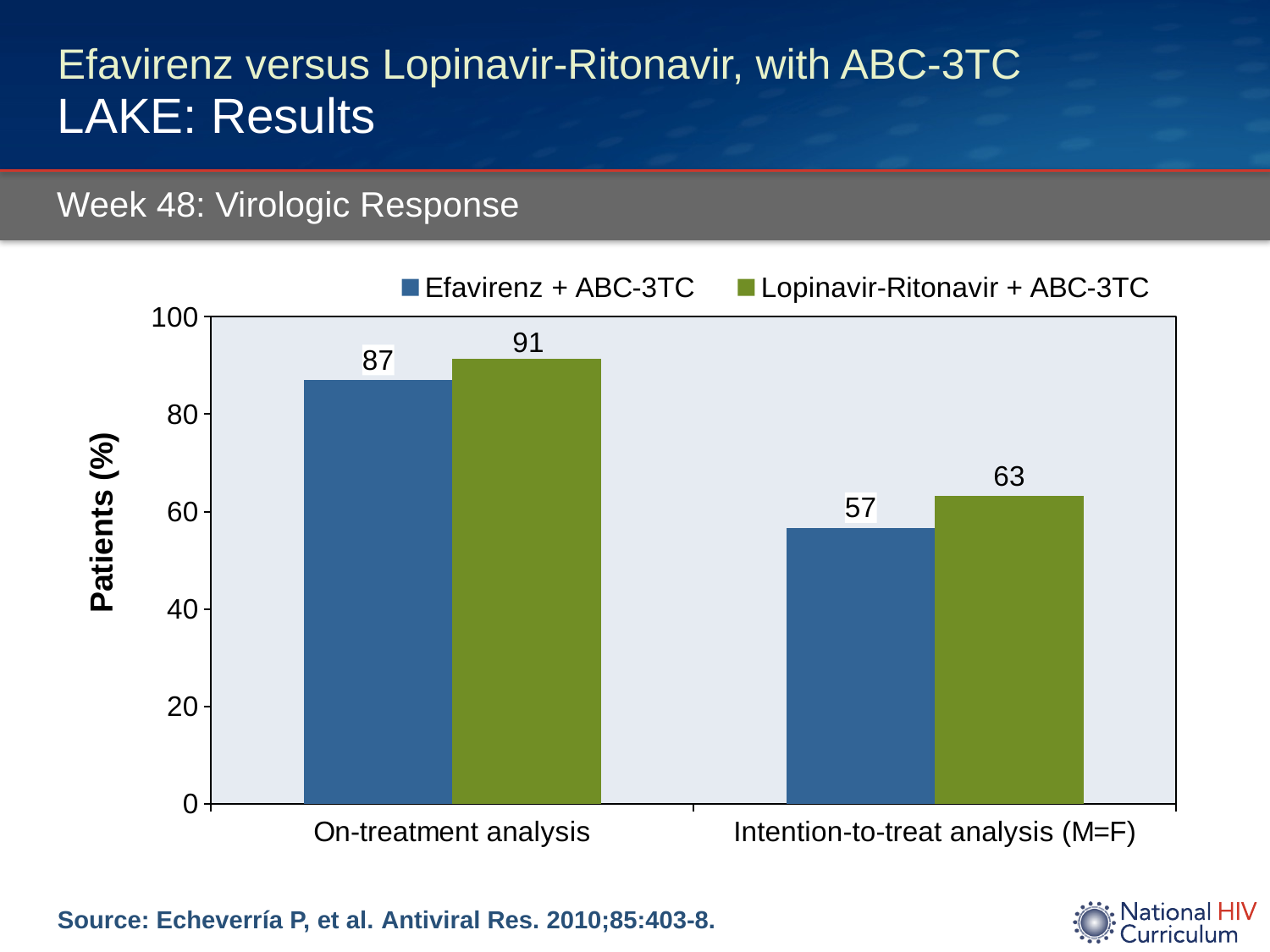
What is the difference between the Lopinavir-Ritonavir + ABC-3TC and Efavirenz + ABC-3TC values in the Intention-to-treat analysis (M=F)? 6 What is the difference between the Lopinavir-Ritonavir + ABC-3TC and Efavirenz + ABC-3TC values in the On-treatment analysis? 4 What is the value for Efavirenz + ABC-3TC in the On-treatment analysis? 87 In the On-treatment analysis, which series has the larger value, Efavirenz + ABC-3TC or Lopinavir-Ritonavir + ABC-3TC? Lopinavir-Ritonavir + ABC-3TC What is the value for Lopinavir-Ritonavir + ABC-3TC in the Intention-to-treat analysis (M=F)? 63 What kind of chart is shown on the slide? Bar chart What is the value for Lopinavir-Ritonavir + ABC-3TC in the On-treatment analysis? 91 How many categories are shown on the x axis? 2 Which bar has the highest value on the chart? Lopinavir-Ritonavir + ABC-3TC, On-treatment analysis Which bar has the lowest value on the chart? Efavirenz + ABC-3TC, Intention-to-treat analysis (M=F) What is the value for Efavirenz + ABC-3TC in the Intention-to-treat analysis (M=F)? 57 How many series does the legend list? 2